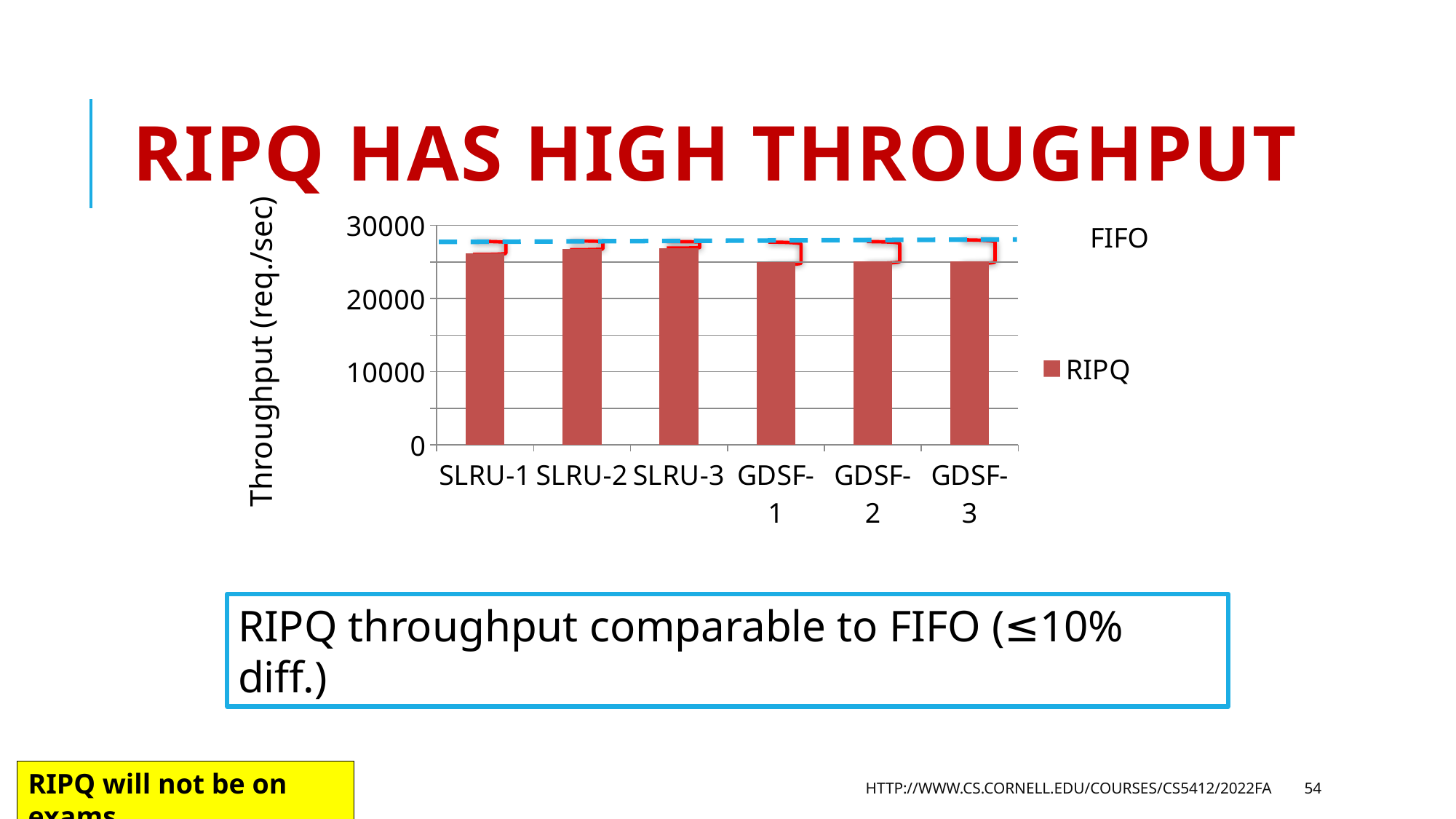
Is the RIPQ value for SLRU-1 greater or less than 20000? greater Is the RIPQ value for SLRU-3 greater or less than 30000? less Which has the higher RIPQ throughput, SLRU-2 or GDSF-2? SLRU-2 Is the RIPQ value for GDSF-2 greater or less than 20000? greater What is the label of the y axis of the chart? Throughput (req./sec) How many categories are shown on the x axis of the chart? 6 Which category appears first on the x axis of the chart? SLRU-1 What does the blue dashed line in the chart represent? FIFO What kind of chart is shown on the slide? bar chart